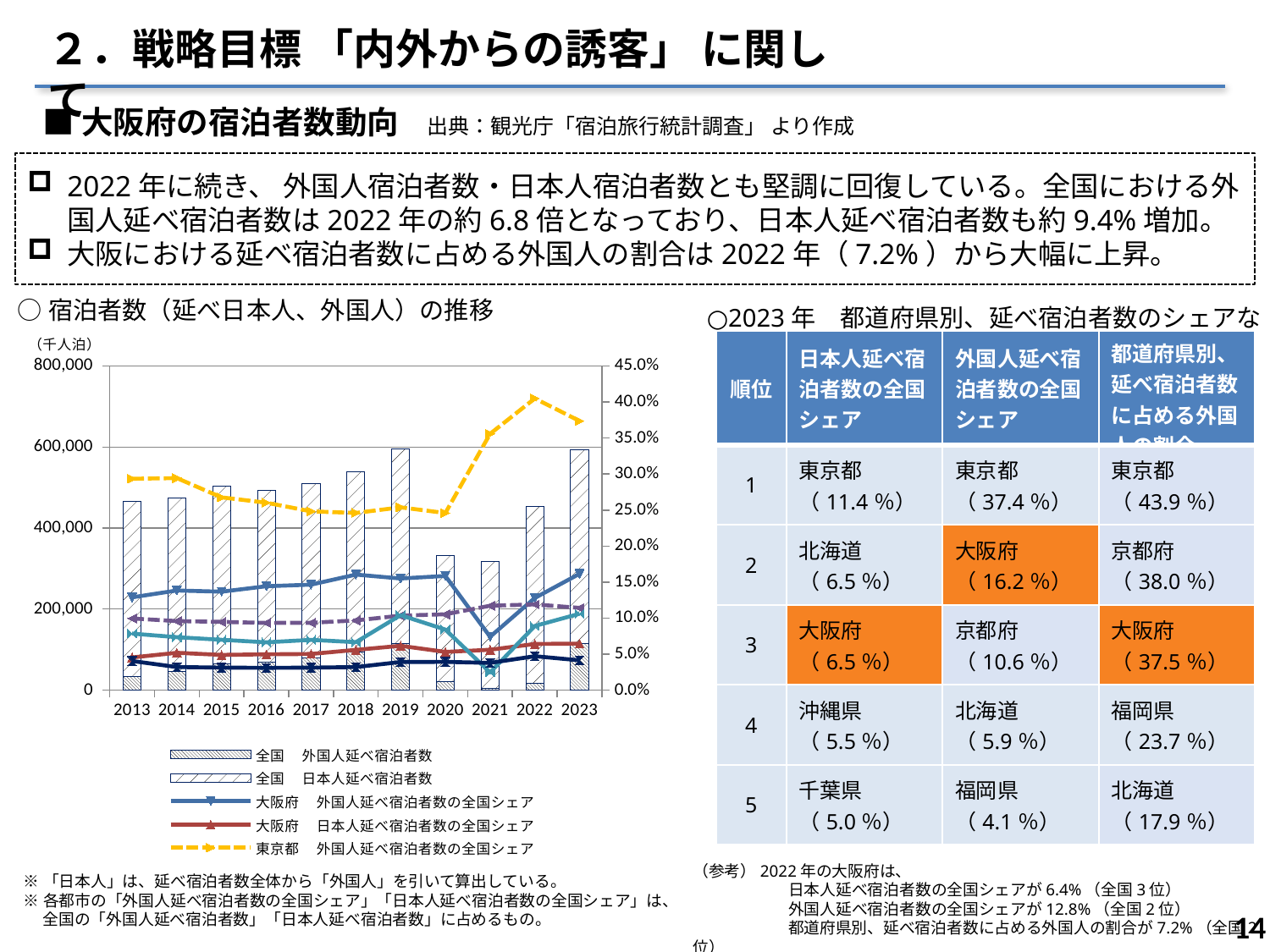
Which year has the larger value for 全国 日本人延べ宿泊者数, 2019 or 2020? 2019 Is the value for 全国 日本人延べ宿泊者数 in 2019 greater or less than 400,000? greater How many years are shown on the x axis of the chart? 11 In which year is 東京都 外国人延べ宿泊者数の全国シェア highest? 2022 Is the value for 全国 外国人延べ宿泊者数 in 2021 greater or less than 200,000? less What is the maximum value shown on the right axis of the chart? 45.0% Is the value for 大阪府 外国人延べ宿泊者数の全国シェア in 2023 greater or less than 10.0%? greater What kind of chart is shown on the slide? Combined bar and line chart In which year is 全国 外国人延べ宿泊者数 lowest? 2021 What unit is shown for the left axis of the chart? 千人泊 Does 全国 外国人延べ宿泊者数 rise or fall from 2013 to 2019? rise